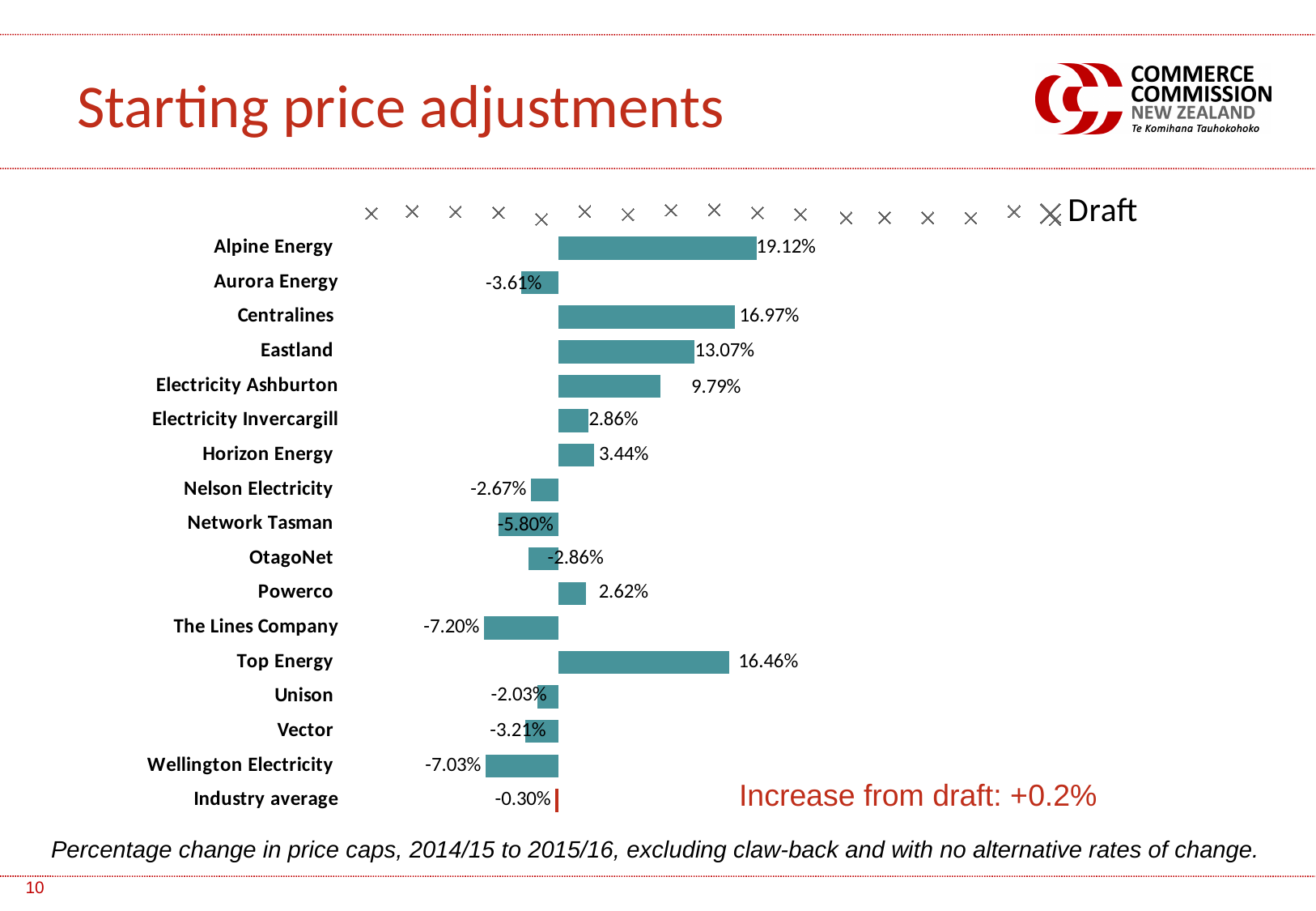
How many categories are shown on the chart? 17 What is the value for Wellington Electricity? -7.03% Which category has the lowest value? The Lines Company What entry does the chart's legend show? Draft What is the difference between the values for Alpine Energy and Centralines? 2.15 percentage points What is the value for Alpine Energy? 19.12% Which is larger, the value for Horizon Energy or the value for Powerco? Horizon Energy What is the difference between the values for Top Energy and Eastland? 3.39 percentage points Which category has the highest value? Alpine Energy What is the value for the Industry average? -0.30% What is the value for Network Tasman? -5.80% What kind of chart is shown on the slide? Bar chart